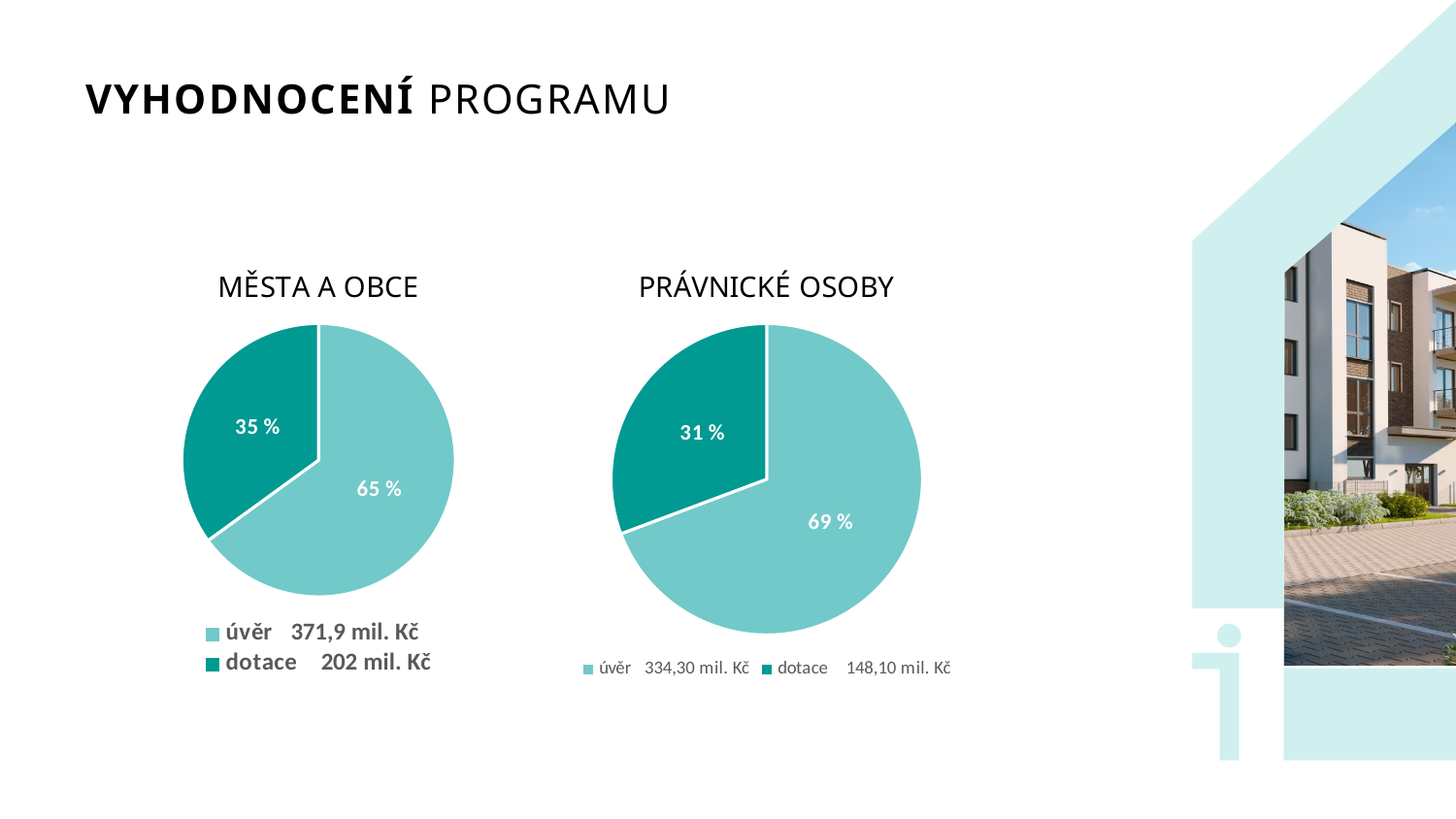
In the PRÁVNICKÉ OSOBY chart, what amount is shown in the legend for dotace? 148,10 mil. Kč In the PRÁVNICKÉ OSOBY chart, which slice is the smallest? dotace In the MĚSTA A OBCE chart, what share of the pie does dotace take? 35 % What kind of chart is the PRÁVNICKÉ OSOBY chart? Pie chart In the MĚSTA A OBCE chart, what amount is shown in the legend for úvěr? 371,9 mil. Kč In the MĚSTA A OBCE chart, which slice is the largest? úvěr In the PRÁVNICKÉ OSOBY chart, what share of the pie does úvěr take? 69 % In the MĚSTA A OBCE chart, what share of the pie does úvěr take? 65 % In the MĚSTA A OBCE chart, what amount is shown in the legend for dotace? 202 mil. Kč In the PRÁVNICKÉ OSOBY chart, what amount is shown in the legend for úvěr? 334,30 mil. Kč How many slices does the MĚSTA A OBCE pie chart have? 2